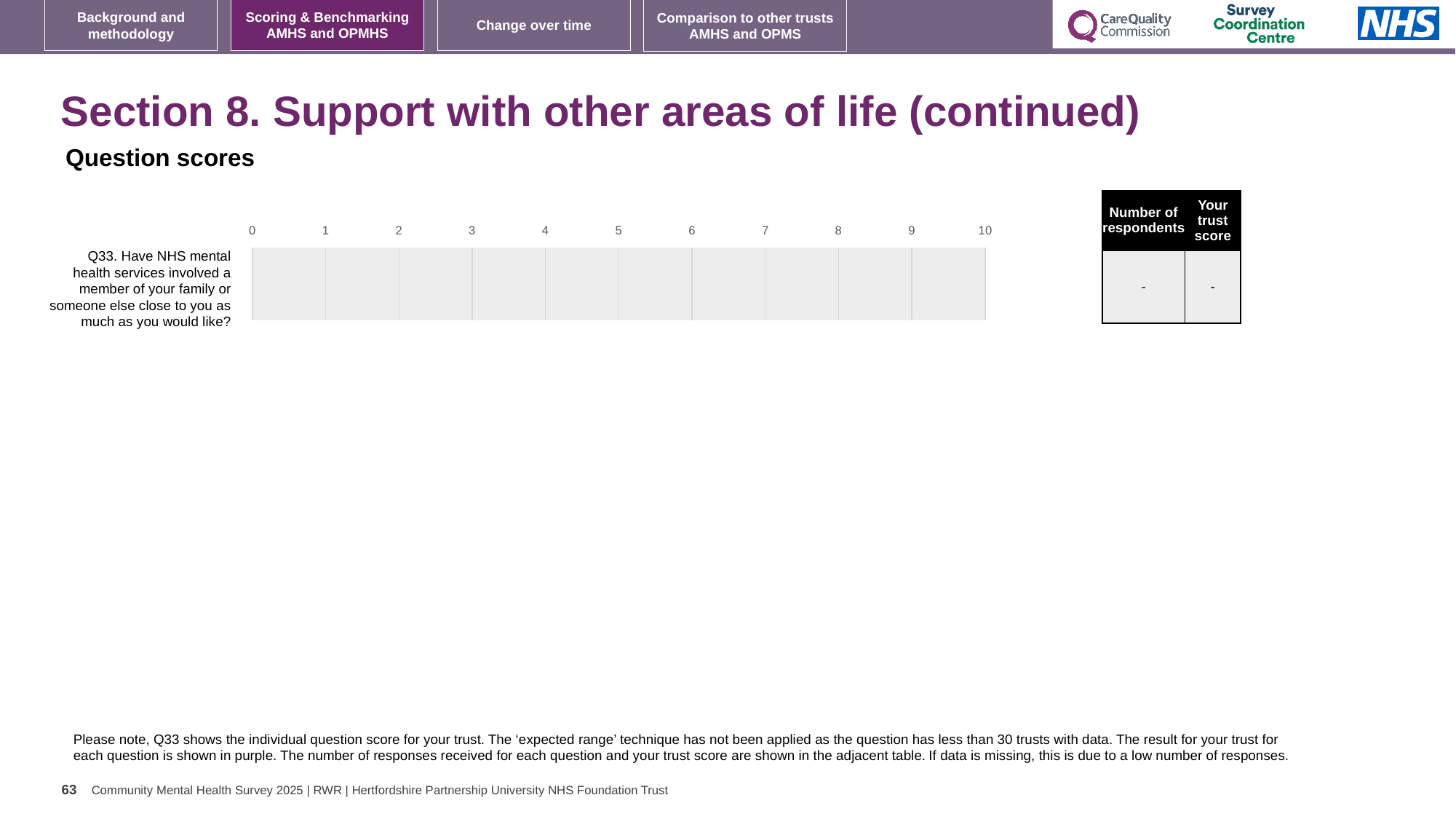
What kind of chart is shown on the slide? bar chart What is the highest value shown on the chart's x axis? 10 What is shown in the 'Number of respondents' column of the table for Q33? - Which question number is shown on the chart? Q33 How many questions (categories) are listed on the chart? 1 What is shown in the 'Your trust score' column of the table for Q33? - Is a bar plotted for Q33 on the chart? No How many tick labels are shown along the x axis? 11 What is the lowest value shown on the chart's x axis? 0